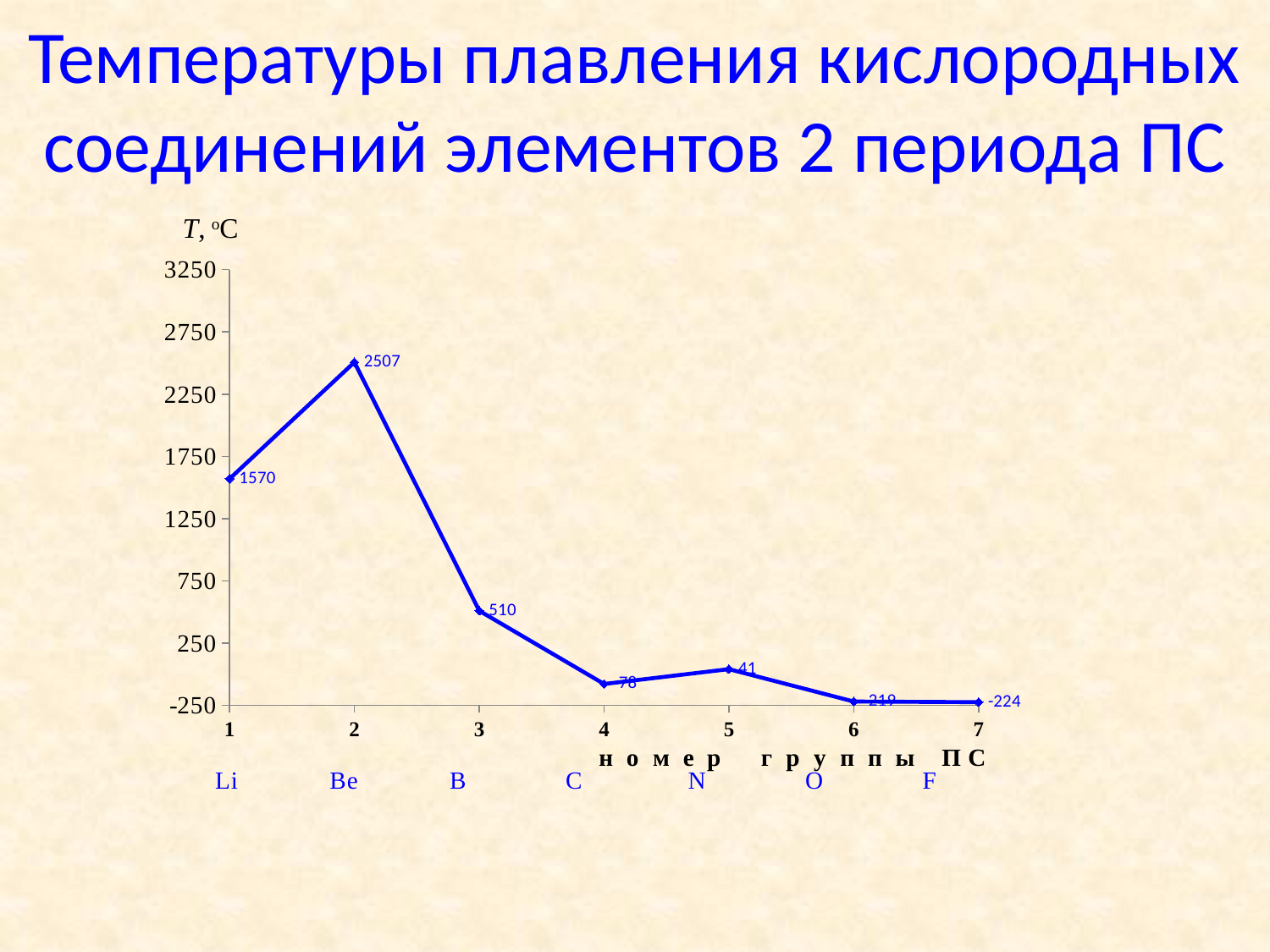
Is the value for C (group 4) greater or less than 250? less What is the value plotted for Be (group 2)? 2507 What is the melting temperature plotted for Li (group 1)? 1570 What is the value plotted for N (group 5)? 41 What is the value plotted for F (group 7)? -224 Which element has the highest plotted melting temperature? Be What kind of chart is shown on the slide? line chart Which is larger, the value for Li or the value for B? Li What is the value plotted for B (group 3)? 510 What is the difference between the values for Be and Li? 937 How many data points are plotted on the chart? 7 Do the values rise or fall from group 2 to group 4? fall